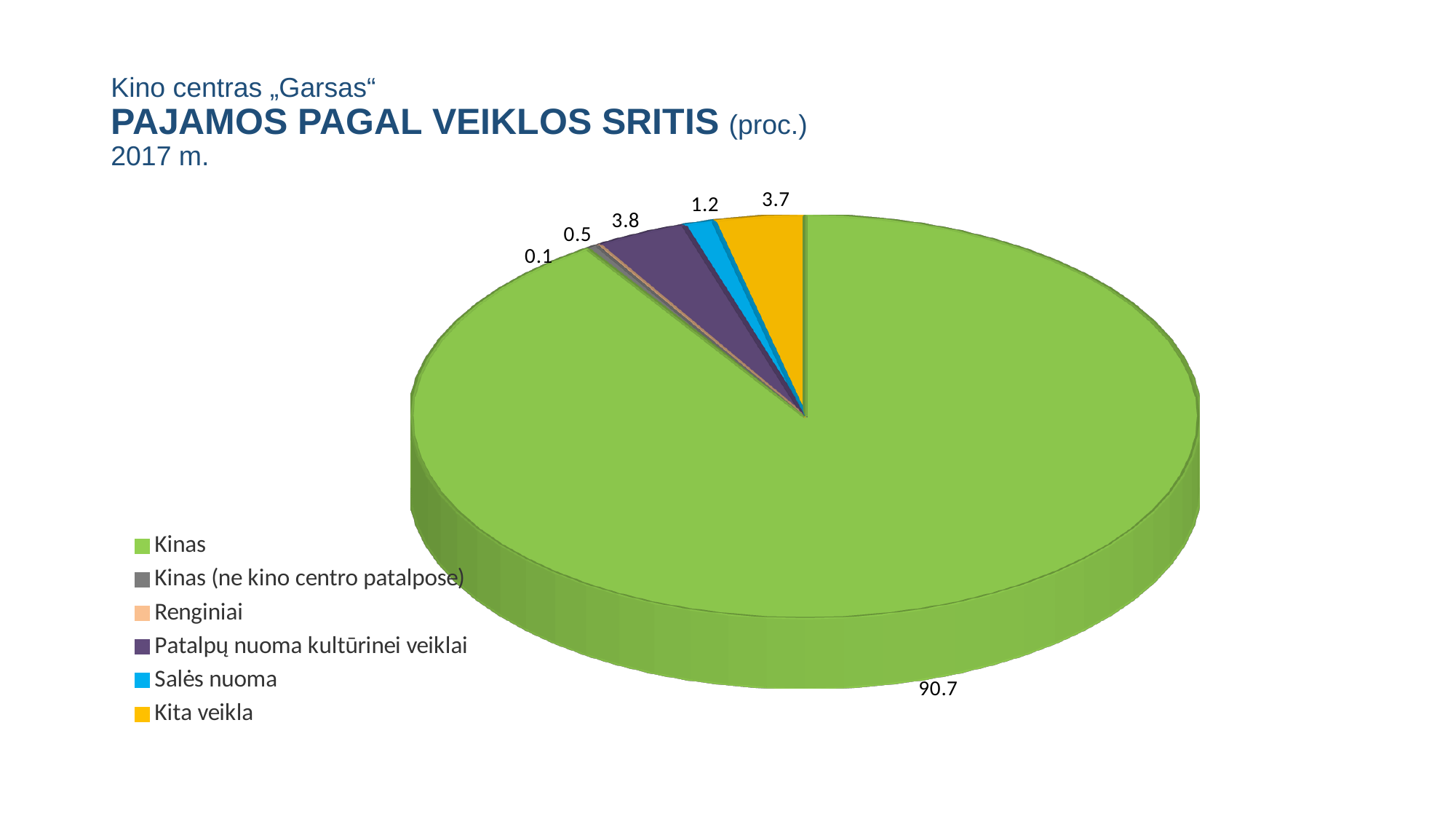
Which year does the chart title refer to? 2017 m. What is the difference between the values for Kinas and Kita veikla? 87 What is the value for Patalpų nuoma kultūrinei veiklai? 3.8 What is the value for Kita veikla? 3.7 How many categories does the legend list? 6 What is the value for Salės nuoma? 1.2 Which is larger, the value for Salės nuoma or the value for Renginiai? Salės nuoma Which category has the largest share of the pie? Kinas What type of chart is shown on the slide? pie chart What is the value for Renginiai? 0.1 Which category has the smallest share of the pie? Renginiai What is the value for Kinas? 90.7